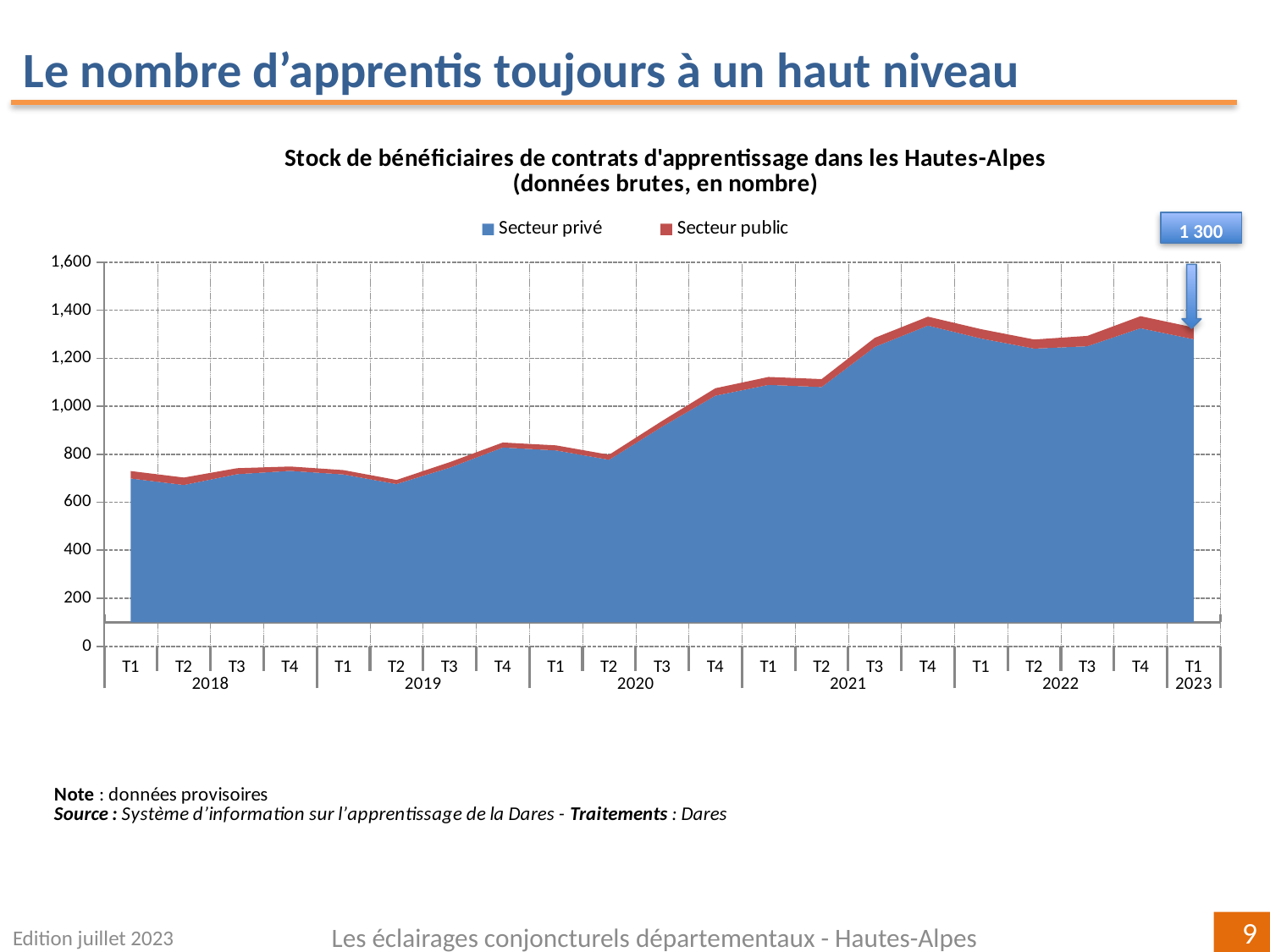
What are the two series named in the legend? Secteur privé and Secteur public Which series occupies the larger part of the stacked area, Secteur privé or Secteur public? Secteur privé How many series does the legend list? 2 Is the total value for T4 2021 greater or less than 1,200? greater Is the total value for T2 2020 greater or less than 1,000? less Which is larger, the total for T3 2020 or the total for T3 2021? T3 2021 What total value is called out for T1 2023? 1 300 Is the total value for T1 2018 greater or less than 800? less What kind of chart is shown on the slide? Area chart How many quarterly points are plotted along the x axis? 21 Overall, do the values rise or fall from 2018 to 2023? rise